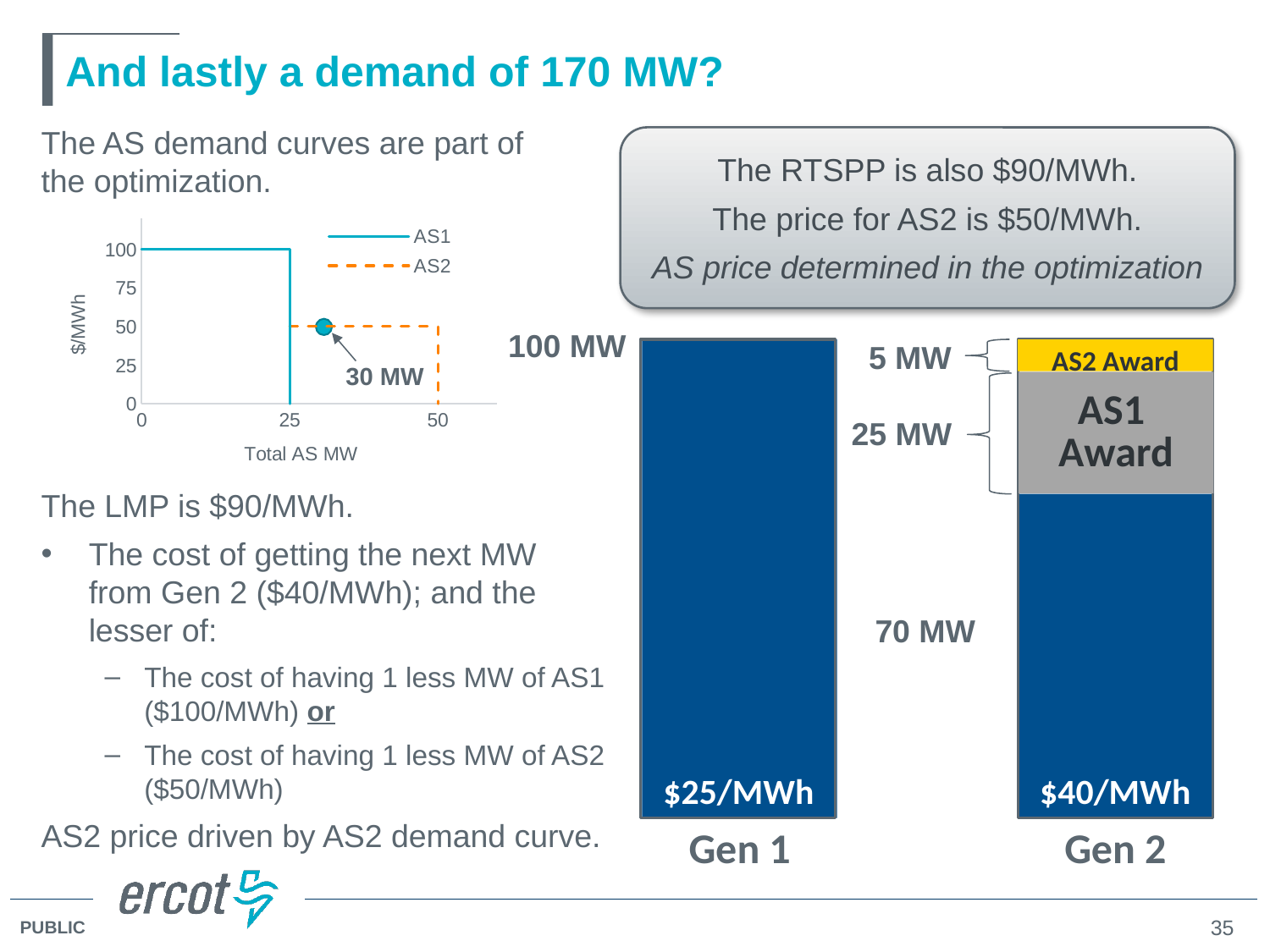
What kind of chart is the chart on the right showing Gen 1 and Gen 2? bar chart In the right bar chart, which generator has the higher $/MWh price, Gen 1 or Gen 2? Gen 2 In the right bar chart, how many MW is the AS2 Award segment of Gen 2? 5 MW In the left line chart, how many series does the legend list? 2 In the right bar chart, what is the difference in MW between the AS1 Award (25 MW) and the AS2 Award (5 MW) for Gen 2? 20 MW In the left line chart, at what $/MWh level does the AS1 curve sit between 0 and 25 Total AS MW? 100 In the right bar chart, what is the total MW of the stacked Gen 2 bar (70 MW + 25 MW + 5 MW)? 100 MW In the left line chart, what label is attached to the marked point on the AS2 curve? 30 MW In the left line chart, at what $/MWh level does the dashed AS2 curve sit between 25 and 50 Total AS MW? 50 In the left line chart, what is the title of the x axis? Total AS MW In the right bar chart, how many MW does the Gen 1 bar represent? 100 MW What kind of chart is the chart on the left with the AS1 and AS2 curves? line chart